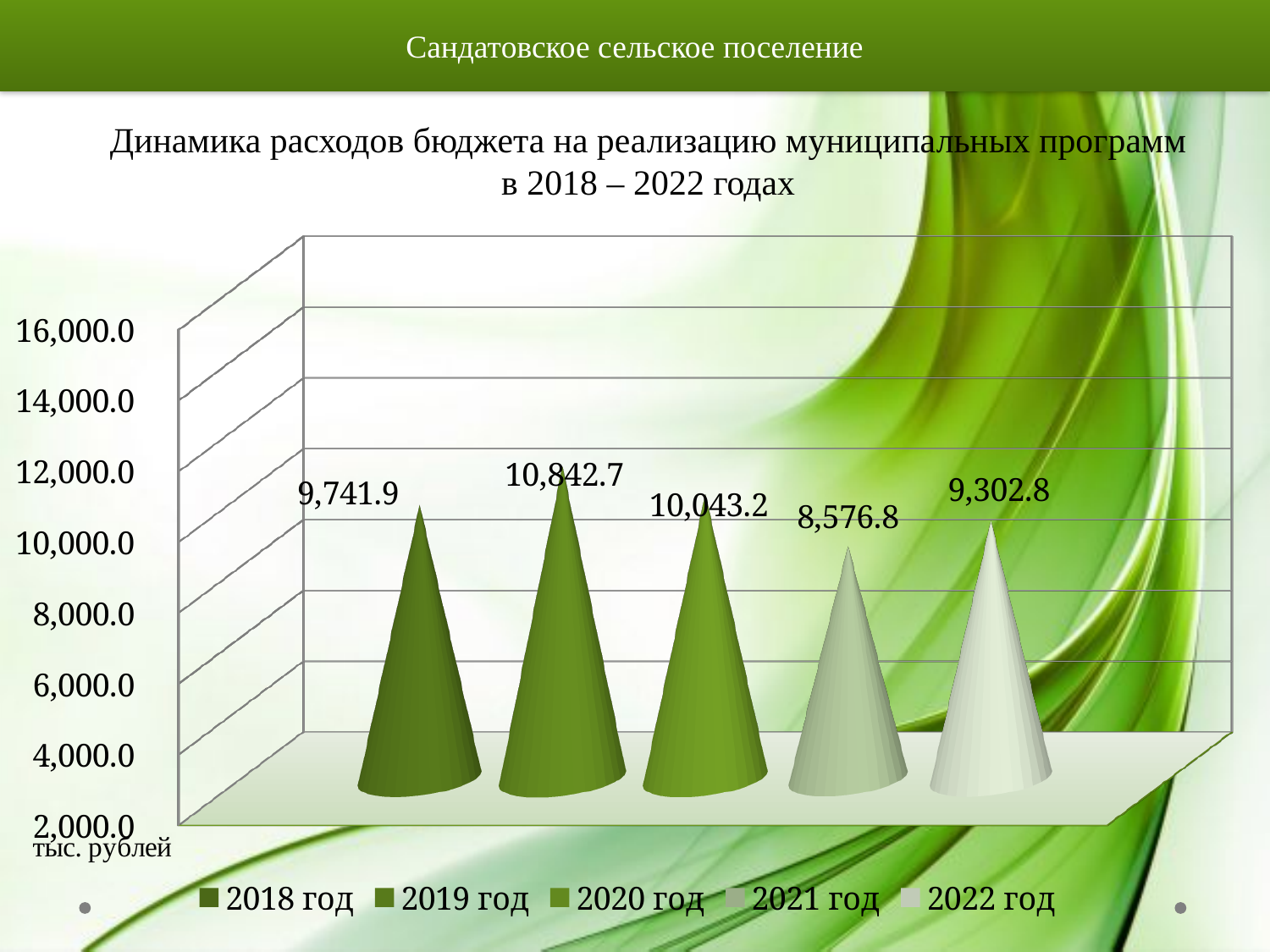
What is the value for 2022 год? 9,302.8 What unit of measurement is shown on the chart? тыс. рублей Which is larger, the value for 2020 год or the value for 2022 год? 2020 год What is the value for 2021 год? 8,576.8 Which year has the lowest value? 2021 год How many entries does the legend list? 5 How many years are plotted on the chart? 5 What is the difference between the values for 2019 год and 2021 год? 2,265.9 What is the value for 2019 год? 10,842.7 Which year has the highest value? 2019 год Is the value for 2021 год greater or less than 10,000.0? less What is the value for 2018 год? 9,741.9